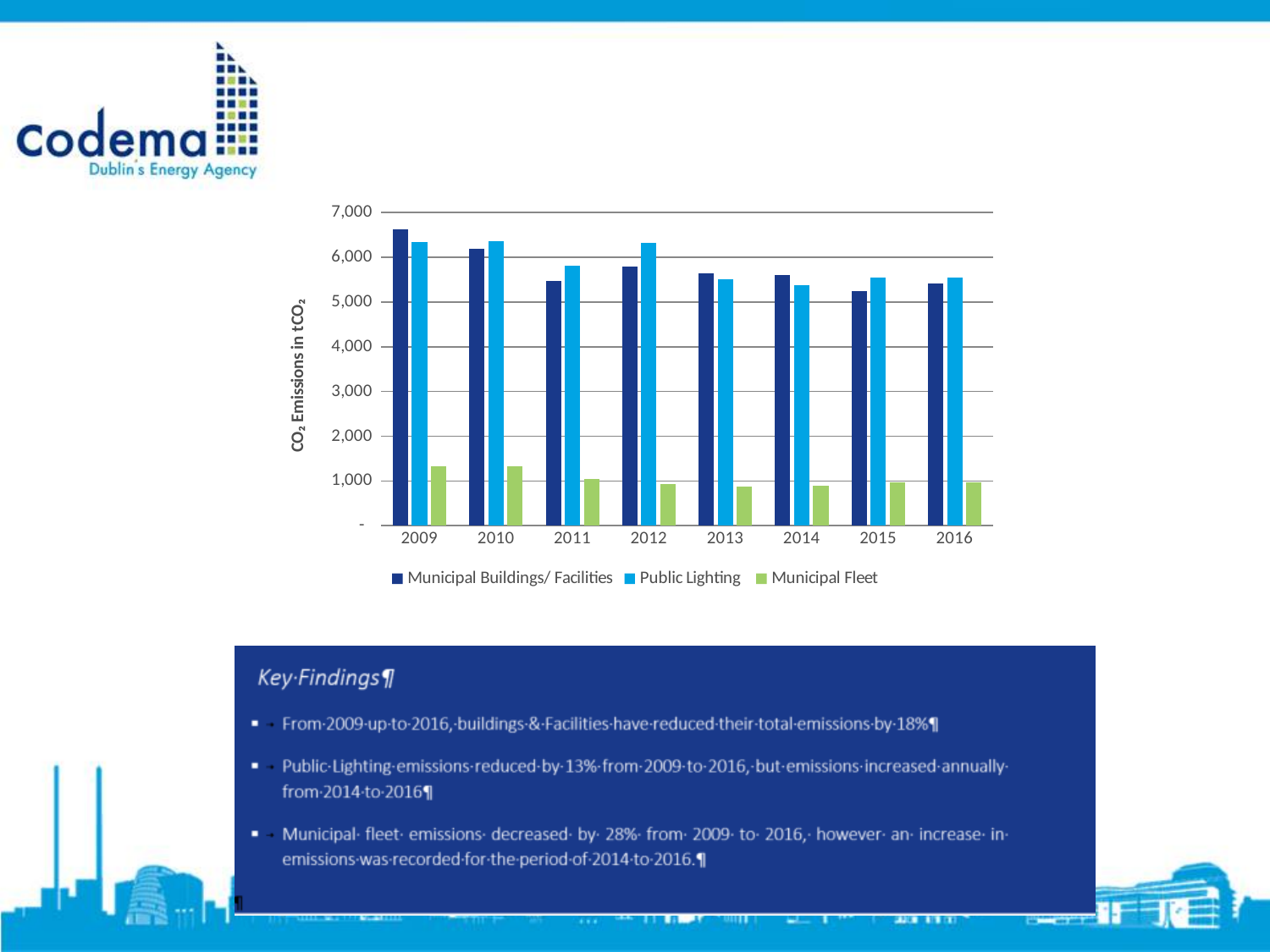
Which series is shown in green in the chart? Municipal Fleet In which year is the Municipal Buildings/ Facilities value highest? 2009 Is the value for Municipal Fleet in 2009 greater or less than 1,000? greater What is the label on the vertical axis of the chart? CO₂ Emissions in tCO₂ What kind of chart is shown on the slide? bar chart In 2009, which is larger: Municipal Buildings/ Facilities or Public Lighting? Municipal Buildings/ Facilities How many series does the chart's legend list? 3 How many years are shown on the x axis of the chart? 8 Is the value for Municipal Fleet in 2013 greater or less than 1,000? less Is the value for Municipal Buildings/ Facilities in 2009 greater or less than 6,000? greater In 2011, which is larger: Municipal Buildings/ Facilities or Public Lighting? Public Lighting